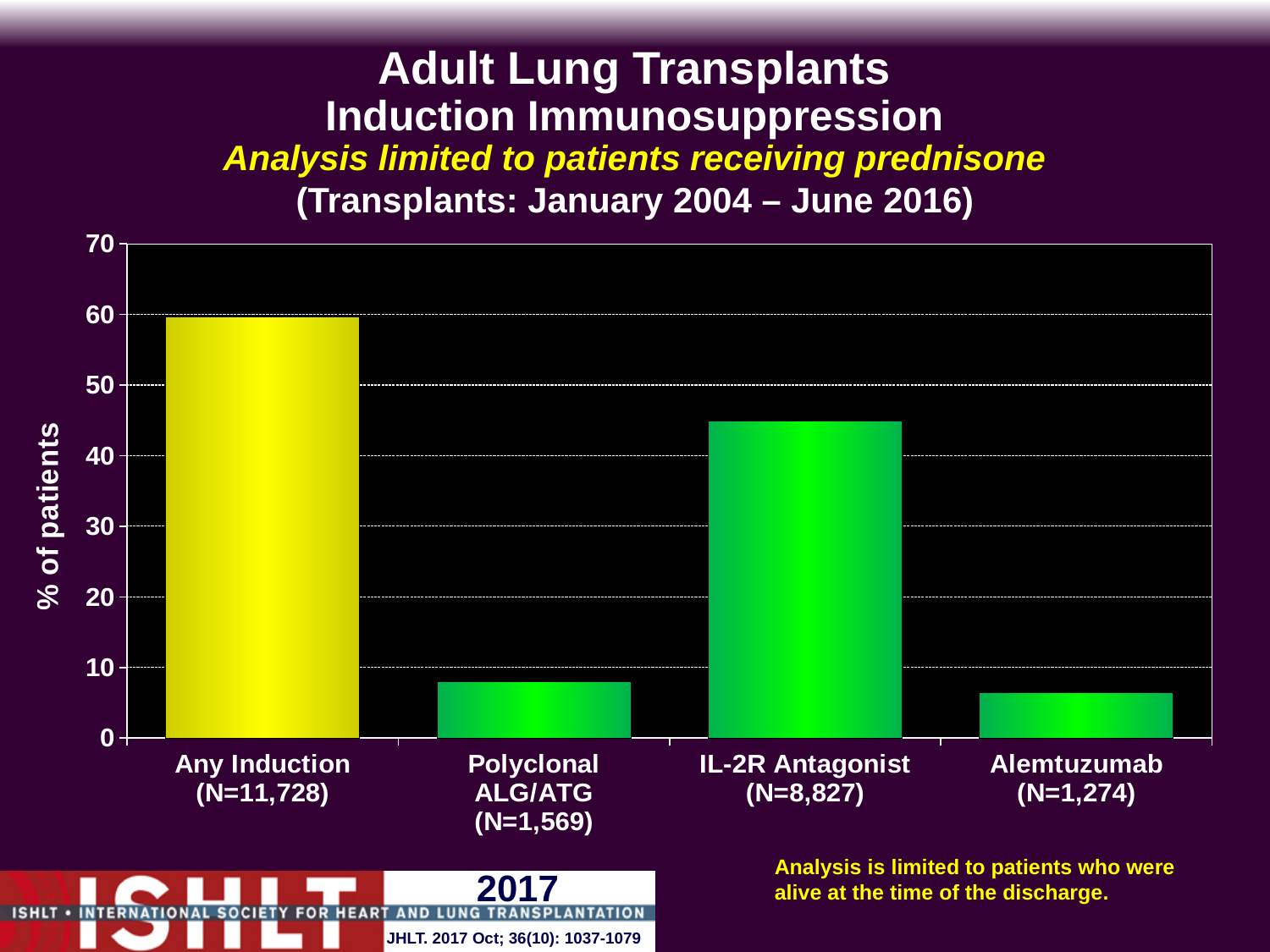
Is the value for Alemtuzumab greater or less than 10? less Is the value for Polyclonal ALG/ATG greater or less than 10? less Which category has the highest percentage of patients? Any Induction (N=11,728) Is the value for IL-2R Antagonist greater or less than 40? greater Which category has the lowest percentage of patients? Alemtuzumab (N=1,274) What type of chart is shown on the slide? bar chart What is the number of patients (N) shown for the IL-2R Antagonist category? N=8,827 How many categories are shown on the x axis of the chart? 4 Which is larger, the value for IL-2R Antagonist or the value for Polyclonal ALG/ATG? IL-2R Antagonist What is the label of the y axis? % of patients